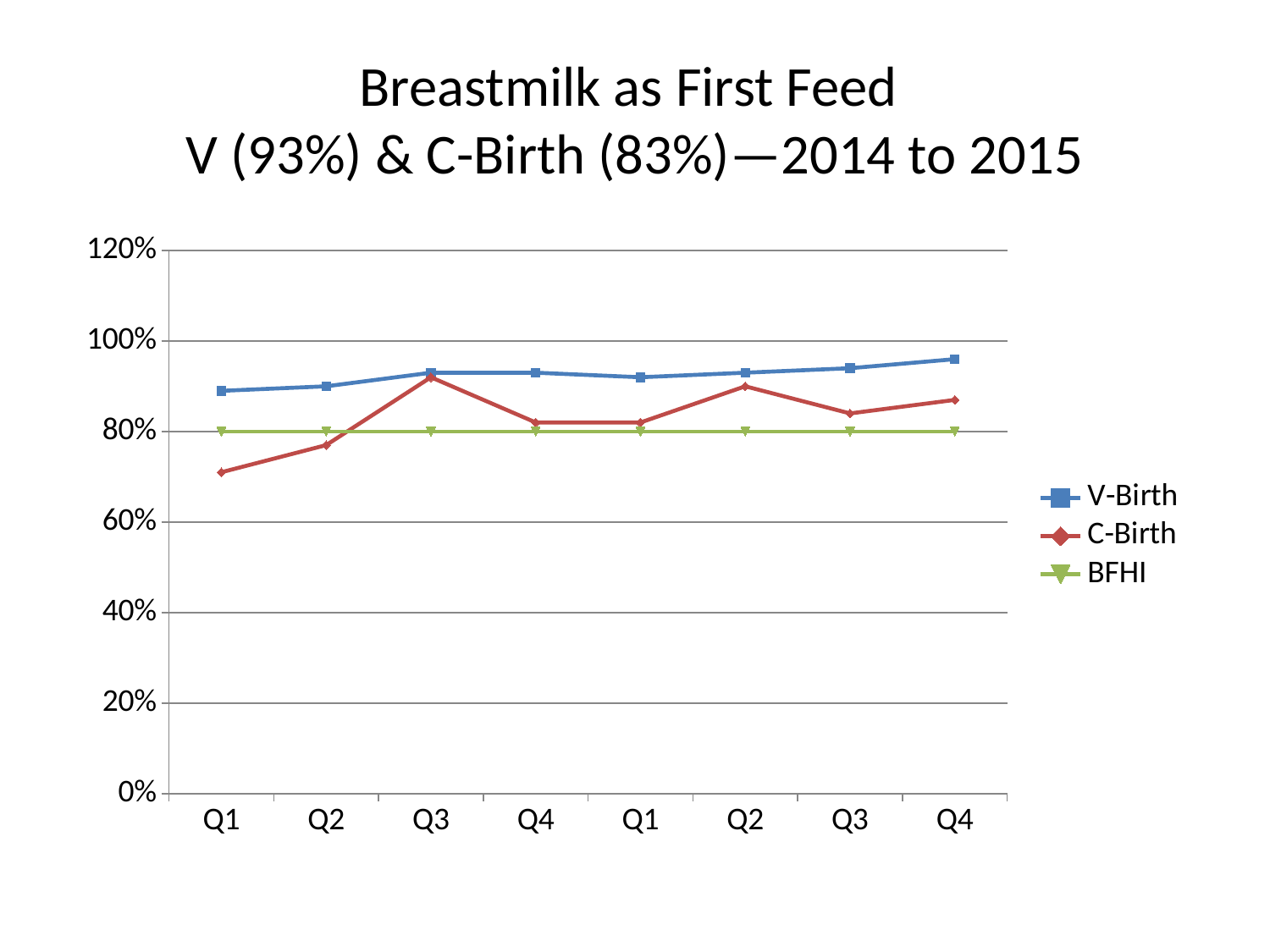
At which quarter is the V-Birth value highest? the last Q4 Is the V-Birth value at the last Q4 greater or less than 100%? less Is the V-Birth value at the first Q1 greater or less than 80%? greater How many points are plotted along the x axis for each series? 8 At which quarter is the C-Birth value lowest? the first Q1 How many series does the legend list? 3 Which is larger at the first Q1, the V-Birth value or the C-Birth value? V-Birth Is the C-Birth value at the first Q1 greater or less than 80%? less What kind of chart is shown on the slide? line chart What is the title of the chart? Breastmilk as First Feed V (93%) & C-Birth (83%)—2014 to 2015 Does the V-Birth line generally rise or fall from the first Q1 to the last Q4? rise What value does the BFHI line hold across all quarters? 80%